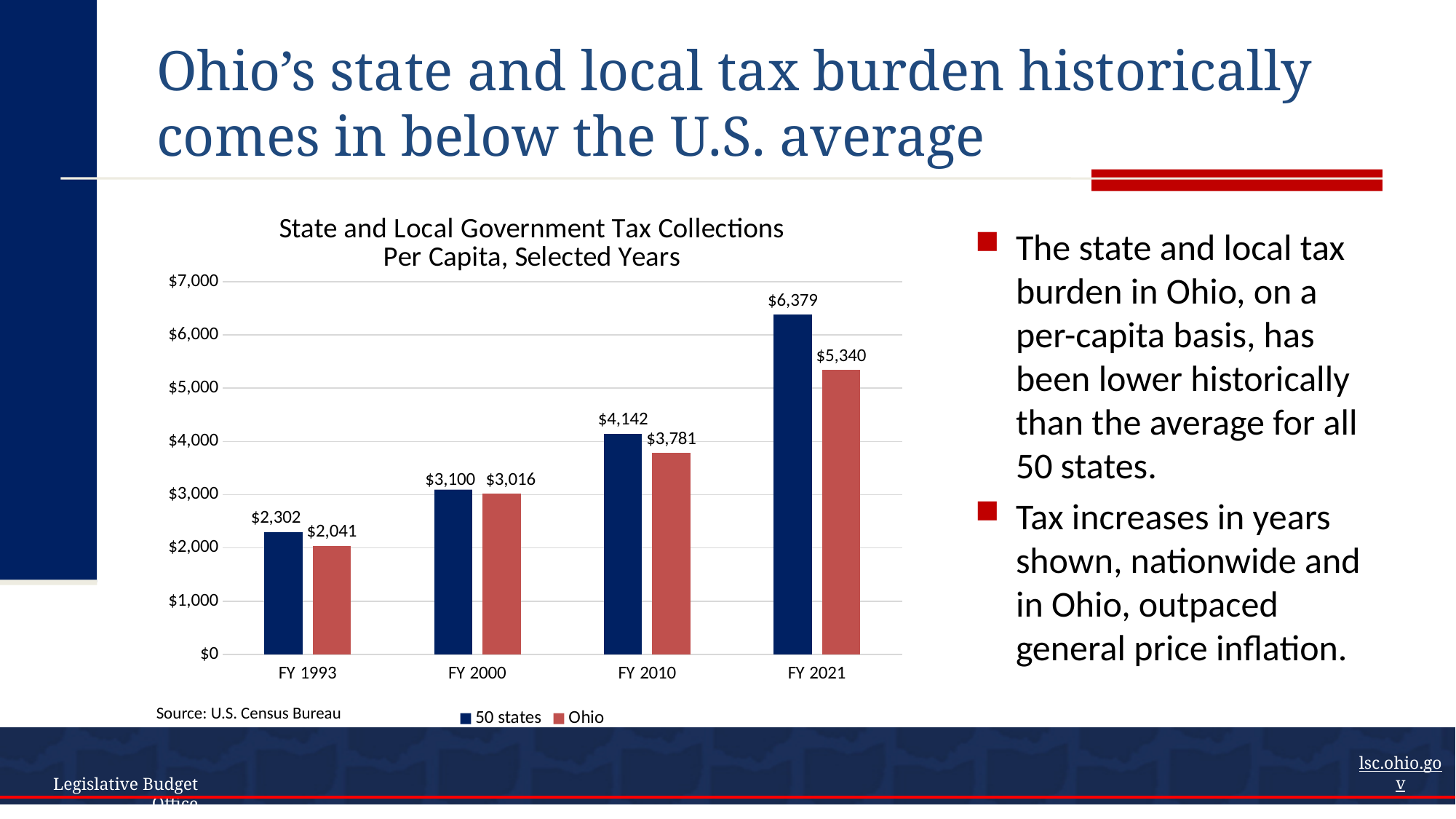
In which year is the 50 states value highest? FY 2021 What kind of chart is shown? Bar chart What is the value for Ohio in FY 1993? $2,041 How many years are shown on the x axis? 4 What is the difference between the 50 states value and the Ohio value in FY 2021? $1,039 What is the difference between the 50 states value and the Ohio value in FY 2000? $84 How many series does the legend list? 2 Which is larger in FY 2010, the 50 states value or the Ohio value? 50 states What is the value for 50 states in FY 2021? $6,379 In which year is the Ohio value lowest? FY 1993 What is the value for Ohio in FY 2010? $3,781 Do the Ohio values rise or fall from FY 1993 to FY 2021? Rise